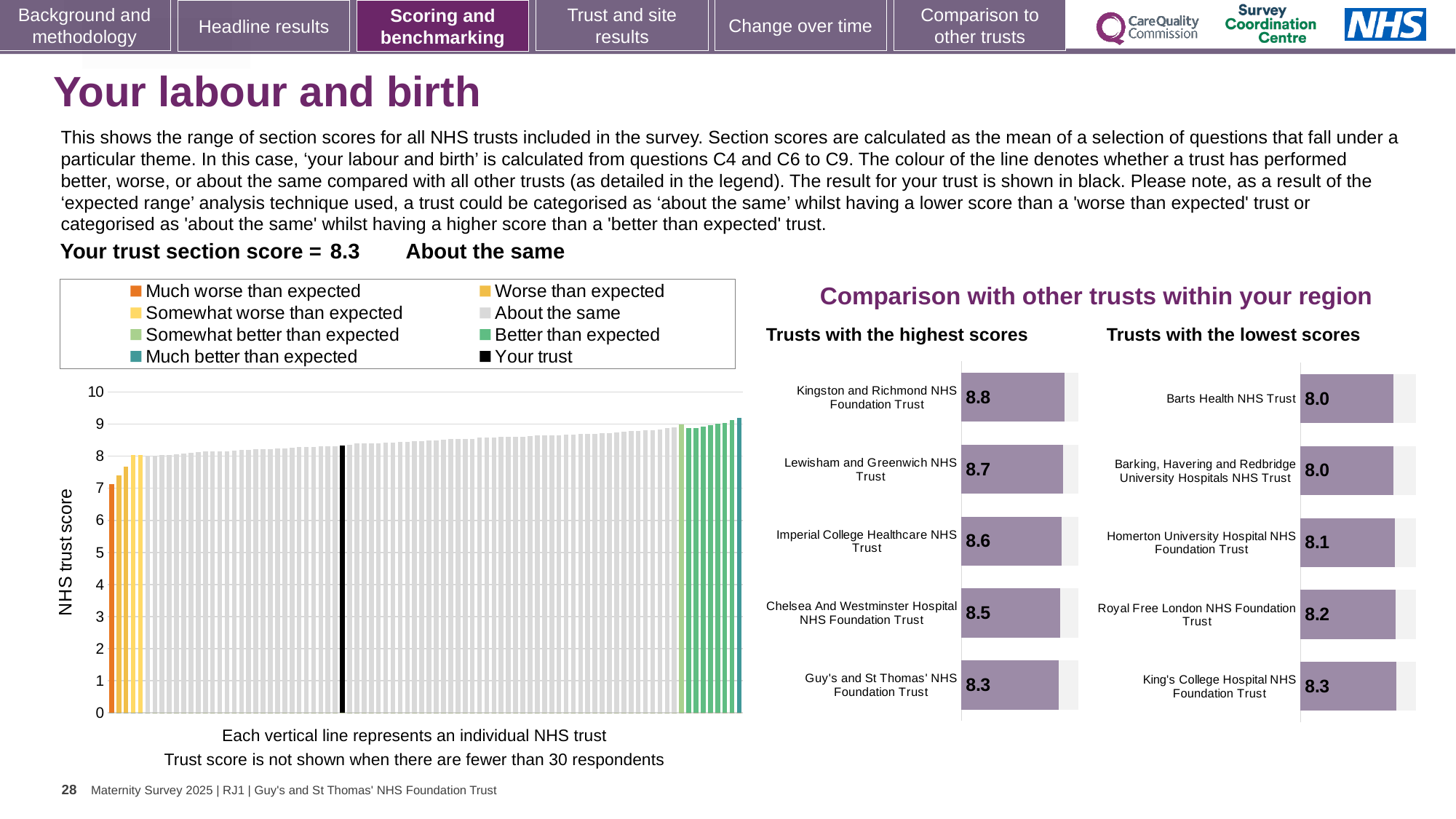
In the 'Trusts with the lowest scores' chart, what is the score for Homerton University Hospital NHS Foundation Trust? 8.1 Which has the higher score: Imperial College Healthcare NHS Trust in the 'highest scores' chart or Homerton University Hospital NHS Foundation Trust in the 'lowest scores' chart? Imperial College Healthcare NHS Trust In the 'Trusts with the highest scores' chart, what is the score for Guy's and St Thomas' NHS Foundation Trust? 8.3 How many trusts are listed in the 'Trusts with the lowest scores' chart? 5 In the 'Trusts with the highest scores' chart, what is the difference between the scores of Kingston and Richmond NHS Foundation Trust and Guy's and St Thomas' NHS Foundation Trust? 0.5 How many entries does the legend above the large 'NHS trust score' chart list? 8 In the 'Trusts with the lowest scores' chart, what is the difference between the scores of Royal Free London NHS Foundation Trust and Barts Health NHS Trust? 0.2 In the 'Trusts with the lowest scores' chart, which trust has the highest score? King's College Hospital NHS Foundation Trust In the 'Trusts with the highest scores' chart, which trust has the highest score? Kingston and Richmond NHS Foundation Trust In the large 'NHS trust score' chart on the left, is the value of the lowest (leftmost) bar greater or less than 8? less In the 'Trusts with the highest scores' chart, what is the score for Kingston and Richmond NHS Foundation Trust? 8.8 In the large 'NHS trust score' chart on the left, do the bar values rise or fall from left to right? rise